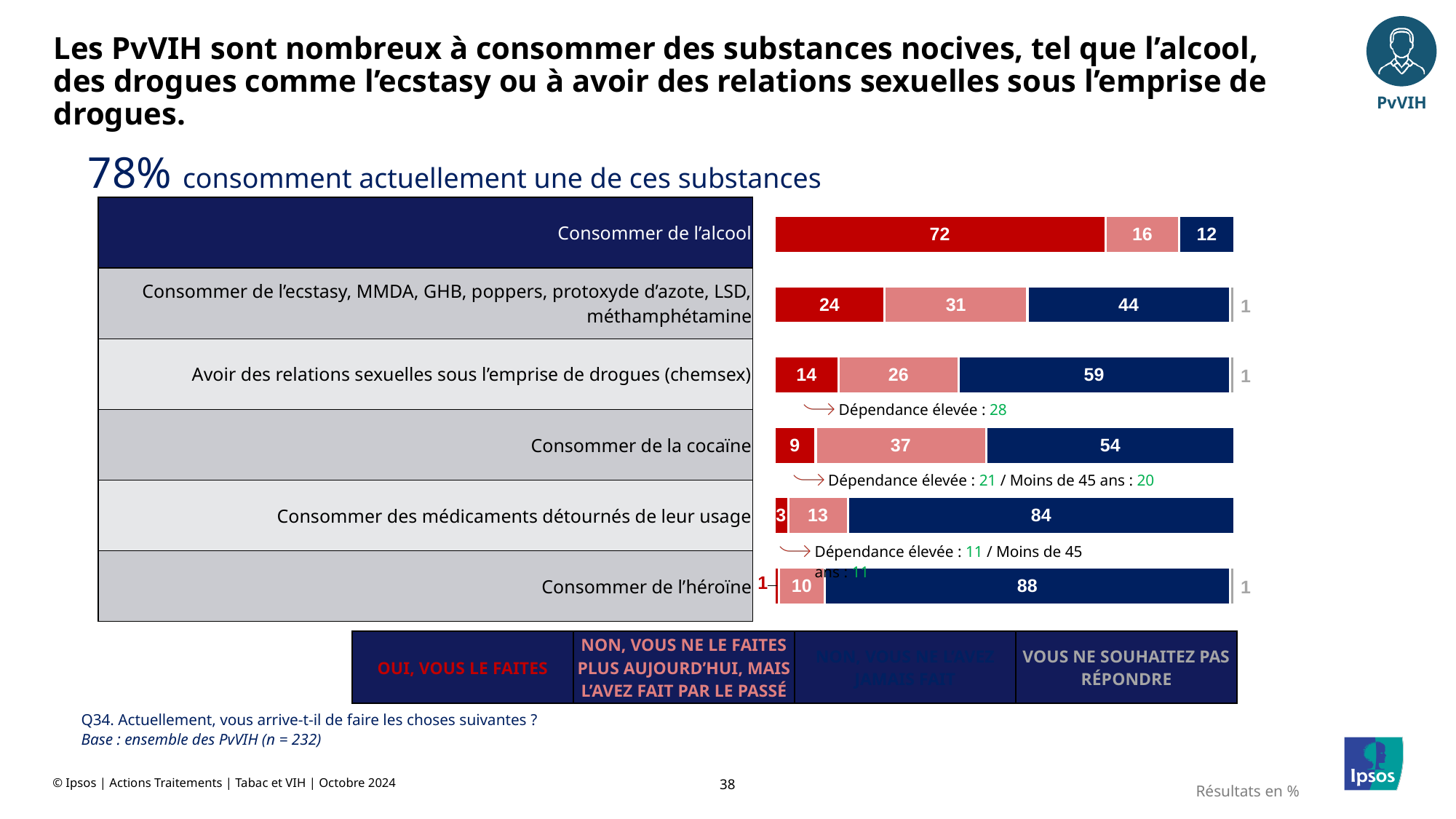
What kind of chart is shown on the slide? Stacked bar chart What is the difference between the "OUI, VOUS LE FAITES" values for "Consommer de l'alcool" and "Consommer de l'ecstasy, MMDA, GHB, poppers, protoxyde d'azote, LSD, méthamphétamine"? 48 What is the largest segment value in the bar for "Consommer des médicaments détournés de leur usage"? 84 What is the value of "OUI, VOUS LE FAITES" for "Consommer de l'alcool"? 72 What is the value of "VOUS NE SOUHAITEZ PAS RÉPONDRE" for "Consommer de l'héroïne"? 1 How many categories are shown in the chart? 6 Which category has the highest value for "OUI, VOUS LE FAITES"? Consommer de l'alcool Which has a higher "OUI, VOUS LE FAITES" value: "Avoir des relations sexuelles sous l'emprise de drogues (chemsex)" or "Consommer de la cocaïne"? Avoir des relations sexuelles sous l'emprise de drogues (chemsex) What is the value of "NON, VOUS NE LE FAITES PLUS AUJOURD'HUI, MAIS L'AVEZ FAIT PAR LE PASSÉ" for "Consommer de la cocaïne"? 37 Which category has the lowest value for "OUI, VOUS LE FAITES"? Consommer de l'héroïne How many series does the legend list? 4 What is the total of the stacked bar for "Consommer de l'alcool"? 100